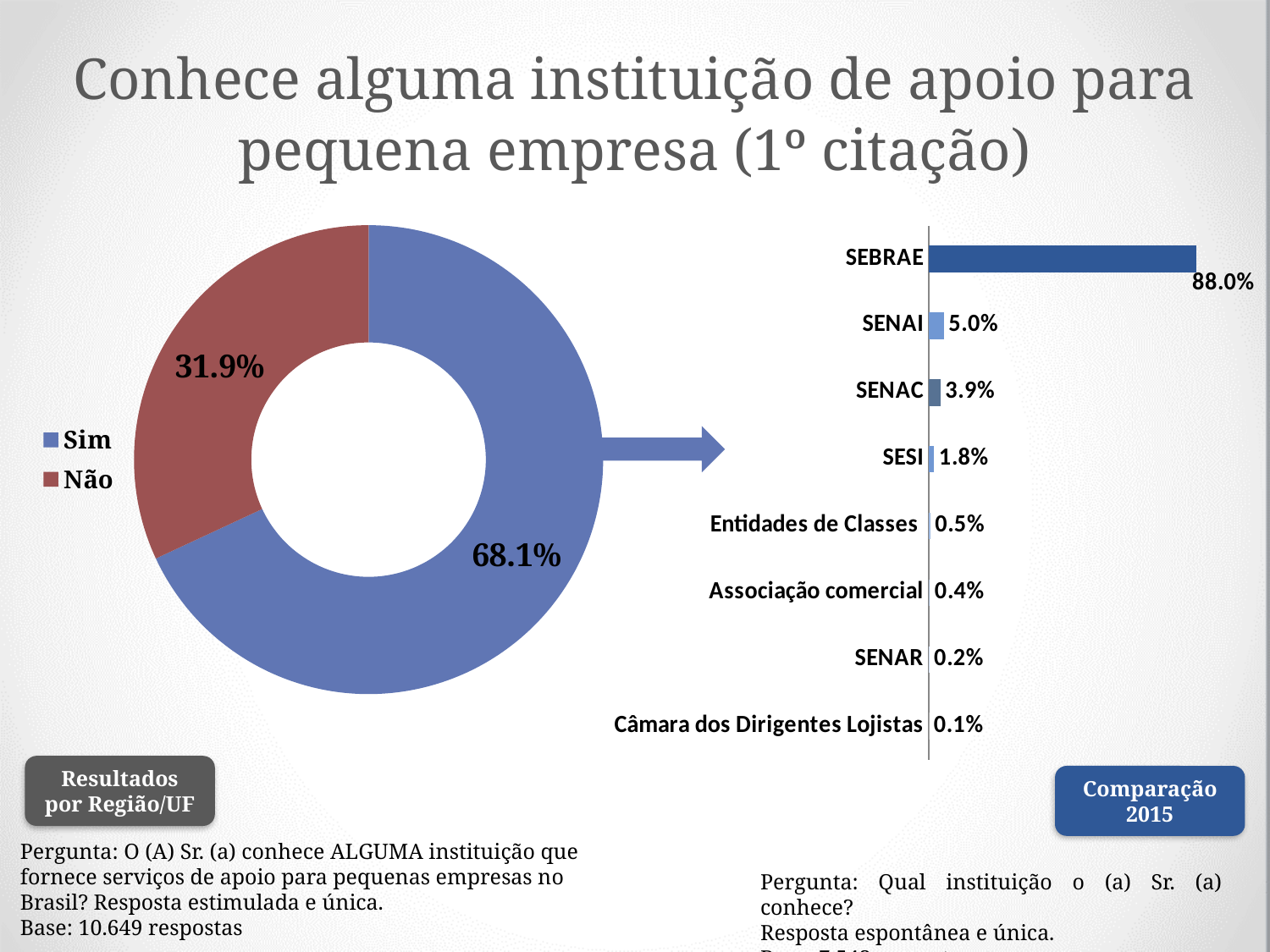
In the bar chart on the right, which institution has the lowest value? Câmara dos Dirigentes Lojistas In the doughnut chart on the left, which answer has the larger share, "Sim" or "Não"? Sim What kind of chart is shown on the right side of the slide? Bar chart In the doughnut chart on the left, how many series does the legend list? 2 In the bar chart on the right, what is the difference between the values for SENAI and SESI? 3.2% In the bar chart on the right, how many institutions are listed? 8 In the doughnut chart on the left, what percentage of respondents answered "Sim"? 68.1% In the bar chart on the right, what is the value for SEBRAE? 88.0% In the bar chart on the right, what is the value for SENAC? 3.9% In the doughnut chart on the left, what is the difference in percentage points between "Sim" and "Não"? 36.2 In the doughnut chart on the left, what percentage of respondents answered "Não"? 31.9% In the bar chart on the right, which institution has the highest value? SEBRAE